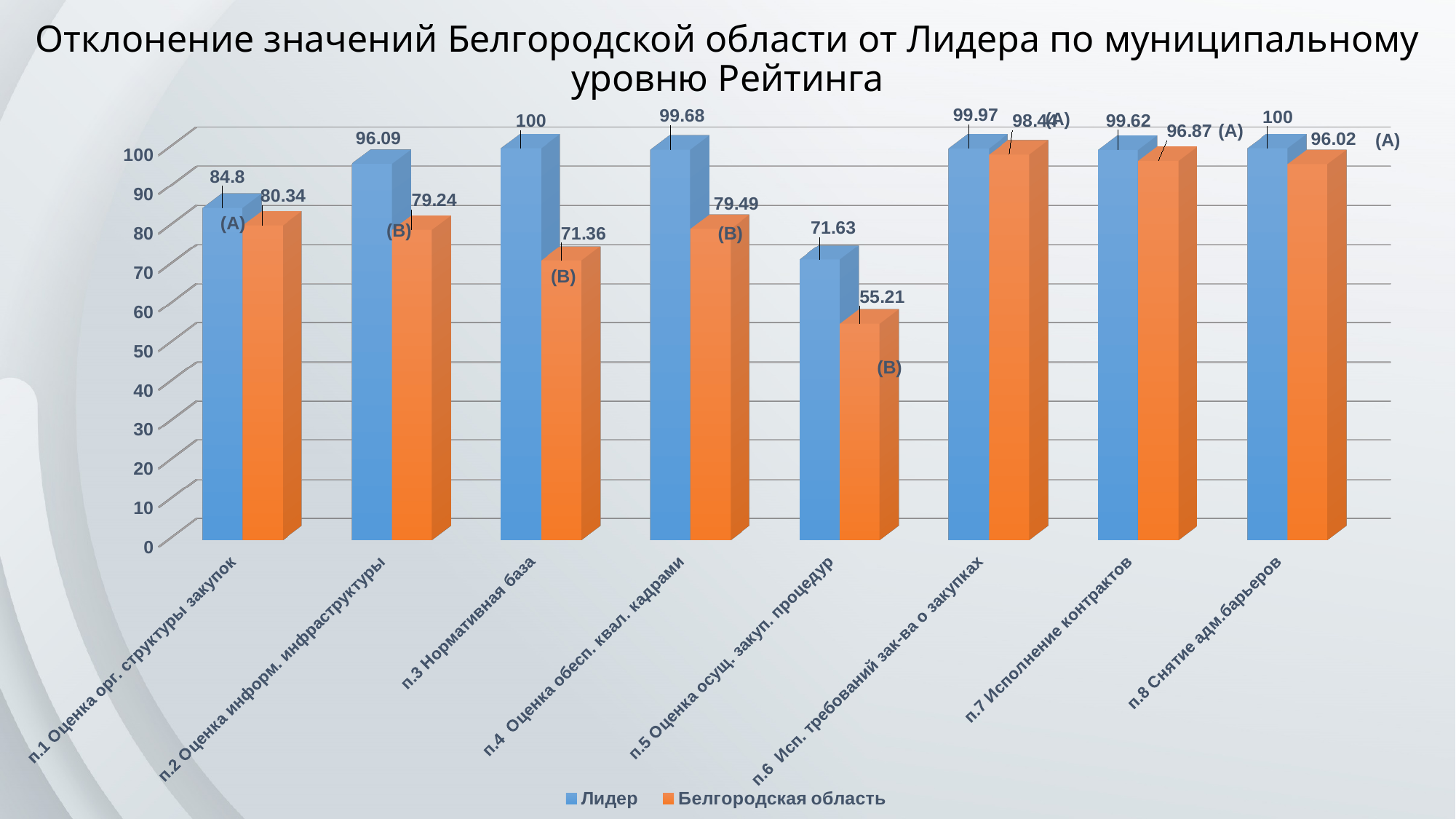
Which is larger in category п.2 Оценка информ. инфраструктуры: Лидер or Белгородская область? Лидер Which category has the lowest value for Белгородская область? п.5 Оценка осущ. закуп. процедур How many categories are shown on the x axis? 8 What is the difference between Лидер and Белгородская область in category п.3 Нормативная база? 28.64 What is the value for Белгородская область in category п.3 Нормативная база? 71.36 What is the value for Лидер in category п.1 Оценка орг. структуры закупок? 84.8 What is the difference between Лидер and Белгородская область in category п.8 Снятие адм.барьеров? 3.98 What is the value for Лидер in category п.7 Исполнение контрактов? 99.62 What is the value for Белгородская область in category п.5 Оценка осущ. закуп. процедур? 55.21 How many series does the legend list? 2 Which category has the lowest value for Лидер? п.5 Оценка осущ. закуп. процедур What kind of chart is shown on the slide? Bar chart